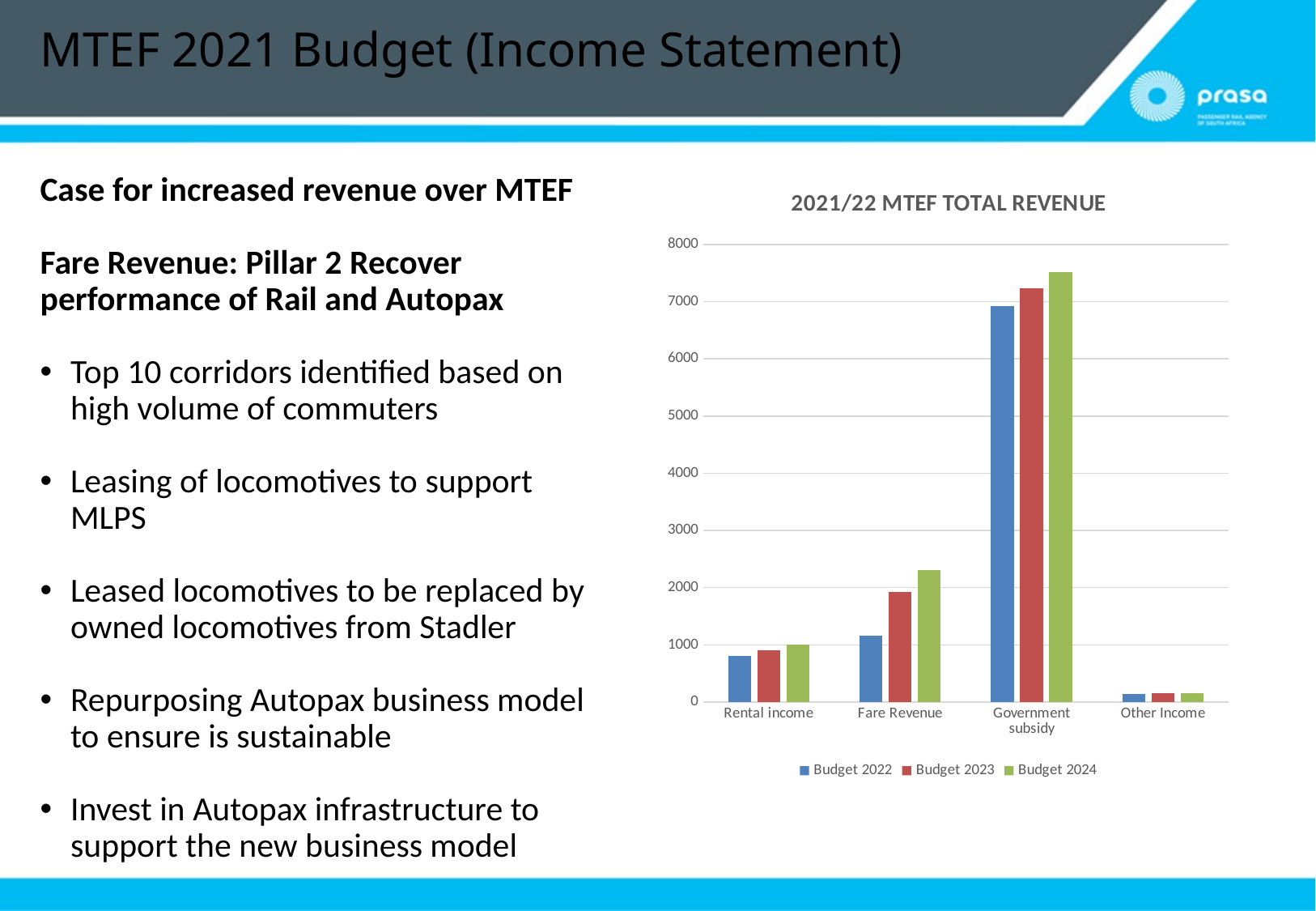
What is the title of the chart? 2021/22 MTEF TOTAL REVENUE Which category has the lowest Budget 2022 value? Other Income What kind of chart is shown on the slide? bar chart Is the Budget 2022 value for Government subsidy greater or less than 6000? greater Is the Budget 2024 value for Fare Revenue greater or less than 2000? greater What colour represents Budget 2024 in the chart? green How many series does the legend of the 2021/22 MTEF TOTAL REVENUE chart list? 3 For Fare Revenue, which is larger: the Budget 2022 value or the Budget 2023 value? Budget 2023 Is the Budget 2022 value for Rental income greater or less than 1000? less How many revenue categories are shown on the x axis of the chart? 4 Do the Fare Revenue values rise or fall from Budget 2022 to Budget 2024? rise Which category has the highest Budget 2024 value? Government subsidy